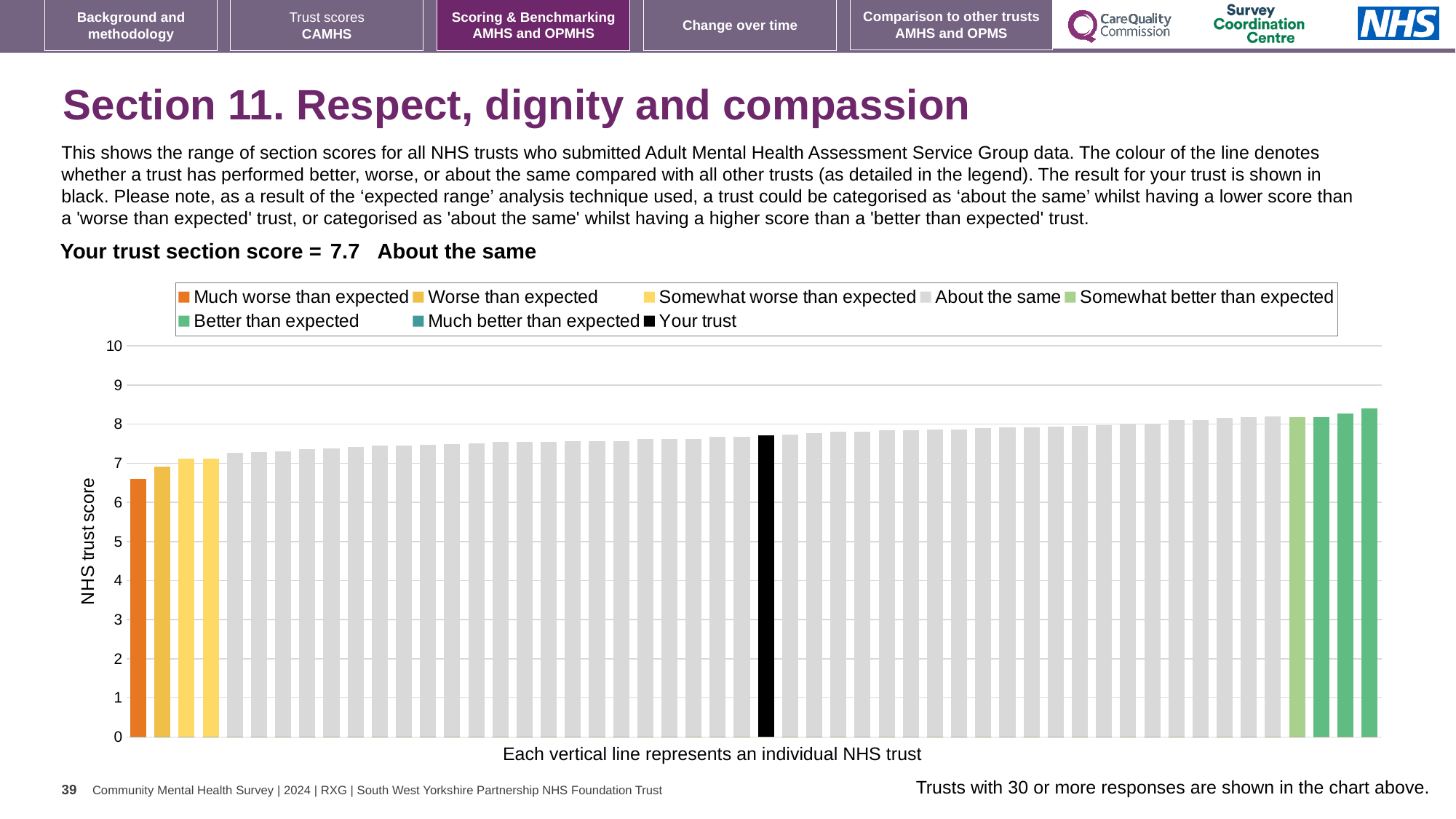
What is the section score for your trust shown on the slide? 7.7 How many entries does the chart legend list? 8 What kind of chart is shown on the slide? bar chart Which category does your trust fall into according to the slide? About the same Is the value of the black 'Your trust' bar greater or less than 7? greater Do the bar values rise or fall from left to right across the chart? rise What is the label on the vertical axis of the chart? NHS trust score What colour is used for the 'Your trust' bar in the chart? black Which legend category does the lowest bar in the chart belong to? Much worse than expected Is the value of the leftmost (orange) bar greater or less than 7? less Is the value of the black 'Your trust' bar greater or less than 8? less